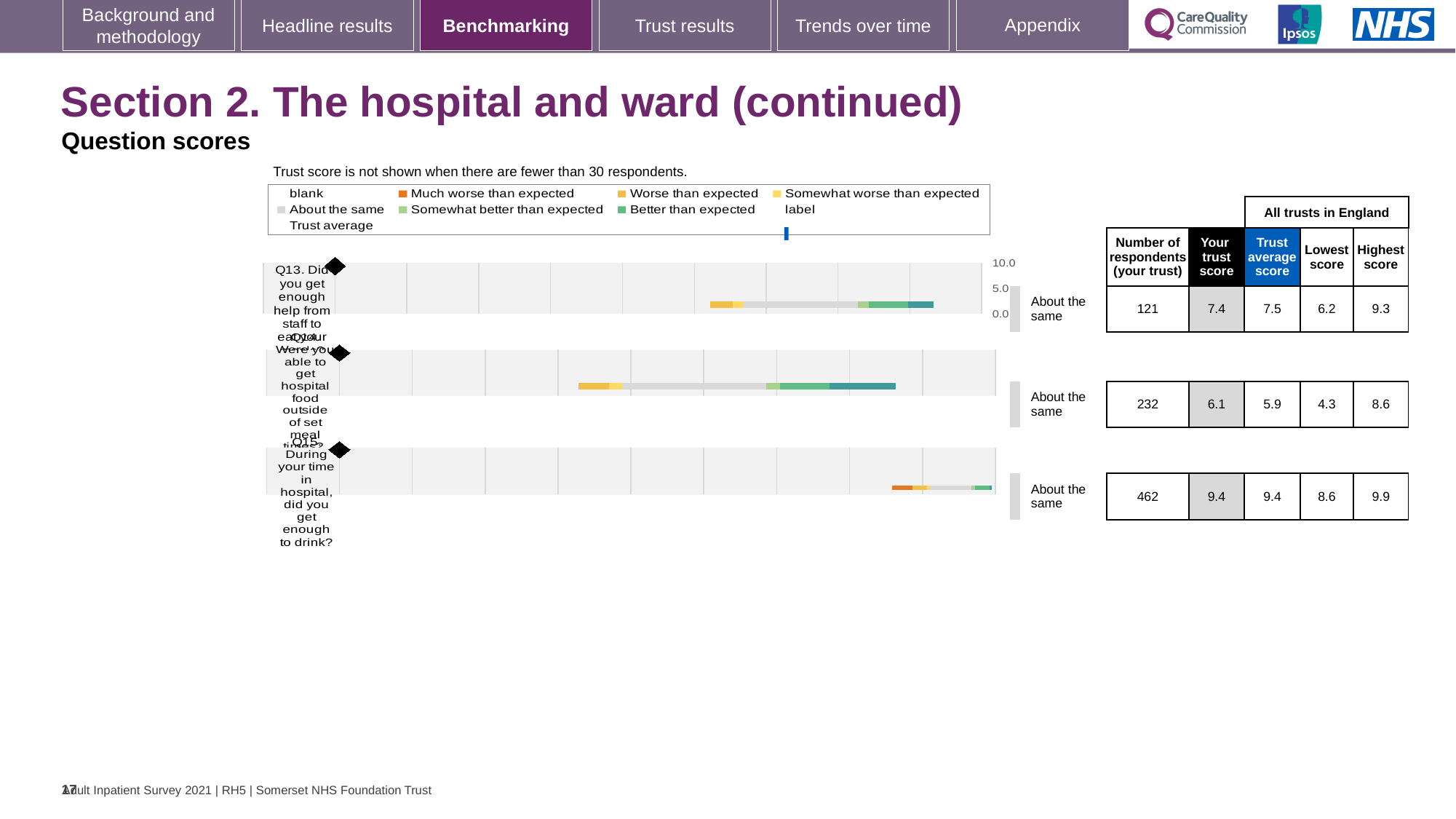
What is the trust average score across all trusts in England for Q14 (Were you able to get hospital food outside of set meal times?)? 5.9 What kind of chart is used to show the question scores on this slide? bar chart Which question has the highest trust score for this trust? Q15 How many respondents answered Q15 (During your time in hospital, did you get enough to drink?) for this trust? 462 What benchmark category is shown for Q13, Q14 and Q15 on this slide? About the same How many questions (categories) are plotted in the benchmarking charts on this slide? 3 What is the minimum number of respondents required for a trust score to be shown, according to the note above the chart? 30 What is the trust score for Q13 (Did you get enough help from staff to eat your meals?)? 7.4 Which question has the lowest number of respondents for this trust? Q13 For Q14, which is larger: the trust score or the trust average score? the trust score What is the highest score among all trusts in England for Q15? 9.9 What is the difference between the highest score and the lowest score for Q13? 3.1